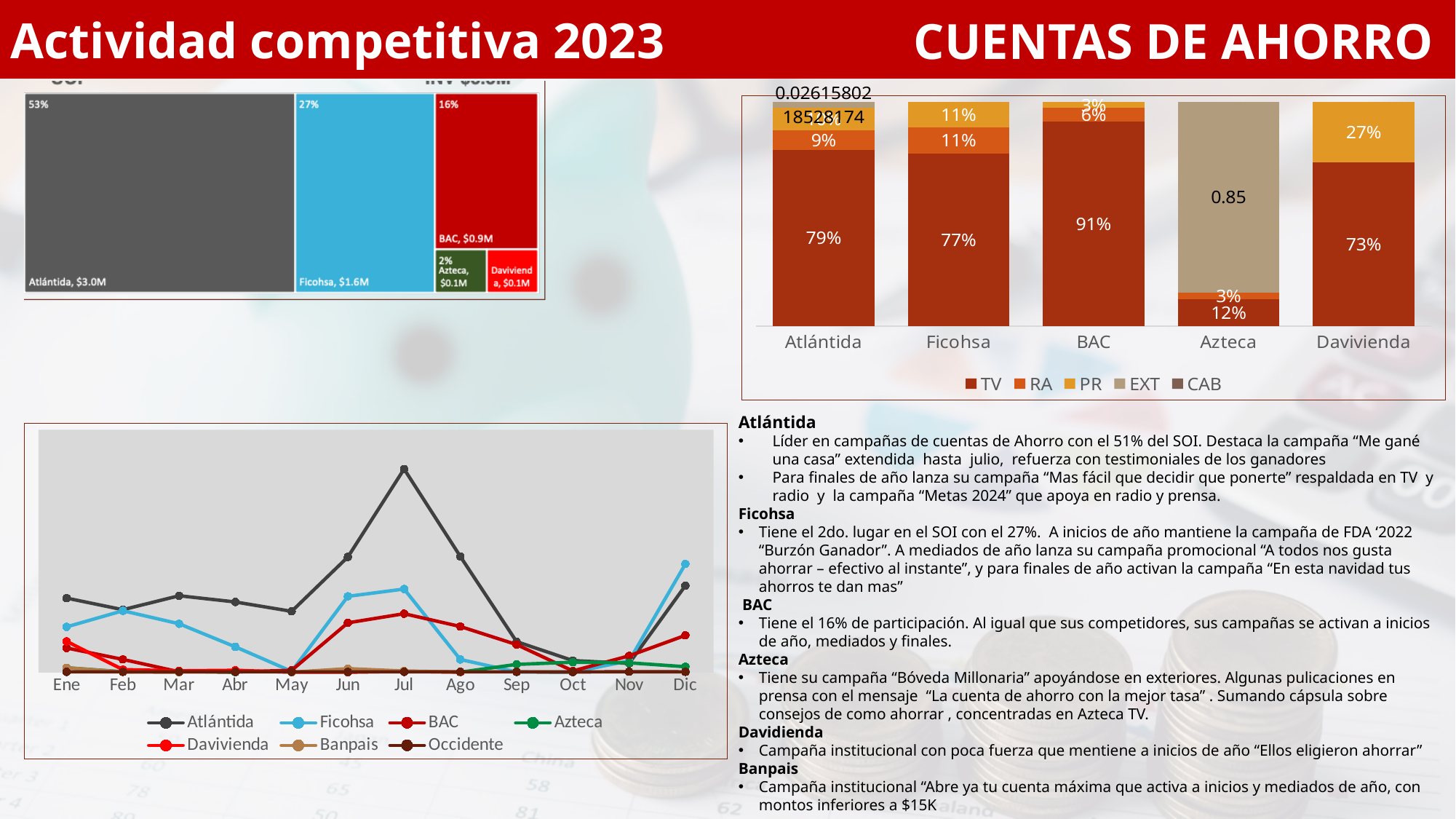
In the stacked bar chart on the right, which brand has the highest TV share? BAC In the stacked bar chart on the right, what is the PR share for Davivienda? 27% In the line chart at the bottom left, how many series does the legend list? 7 In the stacked bar chart on the right, what is the difference between the TV share of Atlántida and that of Ficohsa? 2 percentage points In the stacked bar chart on the right, which brand has the lowest TV share? Azteca In the stacked bar chart on the right, how many series does the legend list? 5 In the treemap at the top left, what percentage share does Atlántida have? 53% In the line chart at the bottom left, in which month does Atlántida reach its peak? Jul In the stacked bar chart on the right, what is the TV share for BAC? 91% What kind of chart is shown at the bottom left of the slide? Line chart In the stacked bar chart on the right, what is the RA share for Ficohsa? 11% In the treemap at the top left, what is the investment amount shown for Ficohsa? $1.6M